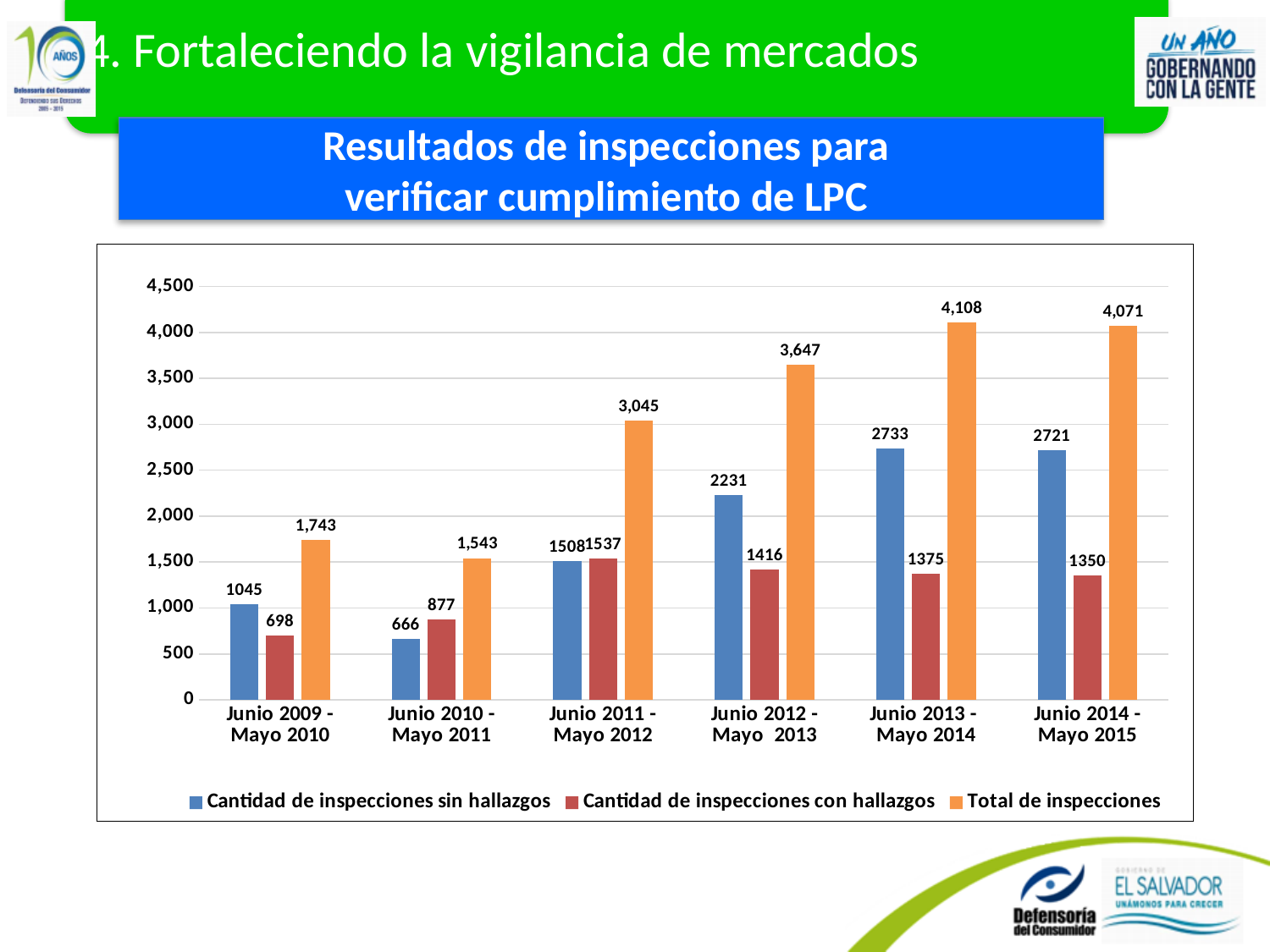
What is the difference between Total de inspecciones for Junio 2014 - Mayo 2015 and Junio 2009 - Mayo 2010? 2,328 Which period has the lowest value for Cantidad de inspecciones sin hallazgos? Junio 2010 - Mayo 2011 Which is larger for Junio 2010 - Mayo 2011: Cantidad de inspecciones sin hallazgos or Cantidad de inspecciones con hallazgos? Cantidad de inspecciones con hallazgos Is the value of Total de inspecciones for Junio 2012 - Mayo 2013 greater or less than 3,500? greater What is the value of Total de inspecciones for Junio 2013 - Mayo 2014? 4,108 What kind of chart is shown on the slide? Bar chart How many periods are shown on the x axis? 6 What is the title of the chart? Resultados de inspecciones para verificar cumplimiento de LPC What is the value of Cantidad de inspecciones con hallazgos for Junio 2010 - Mayo 2011? 877 Which period has the highest value for Total de inspecciones? Junio 2013 - Mayo 2014 What is the value of Cantidad de inspecciones sin hallazgos for Junio 2012 - Mayo 2013? 2231 How many series does the legend list? 3